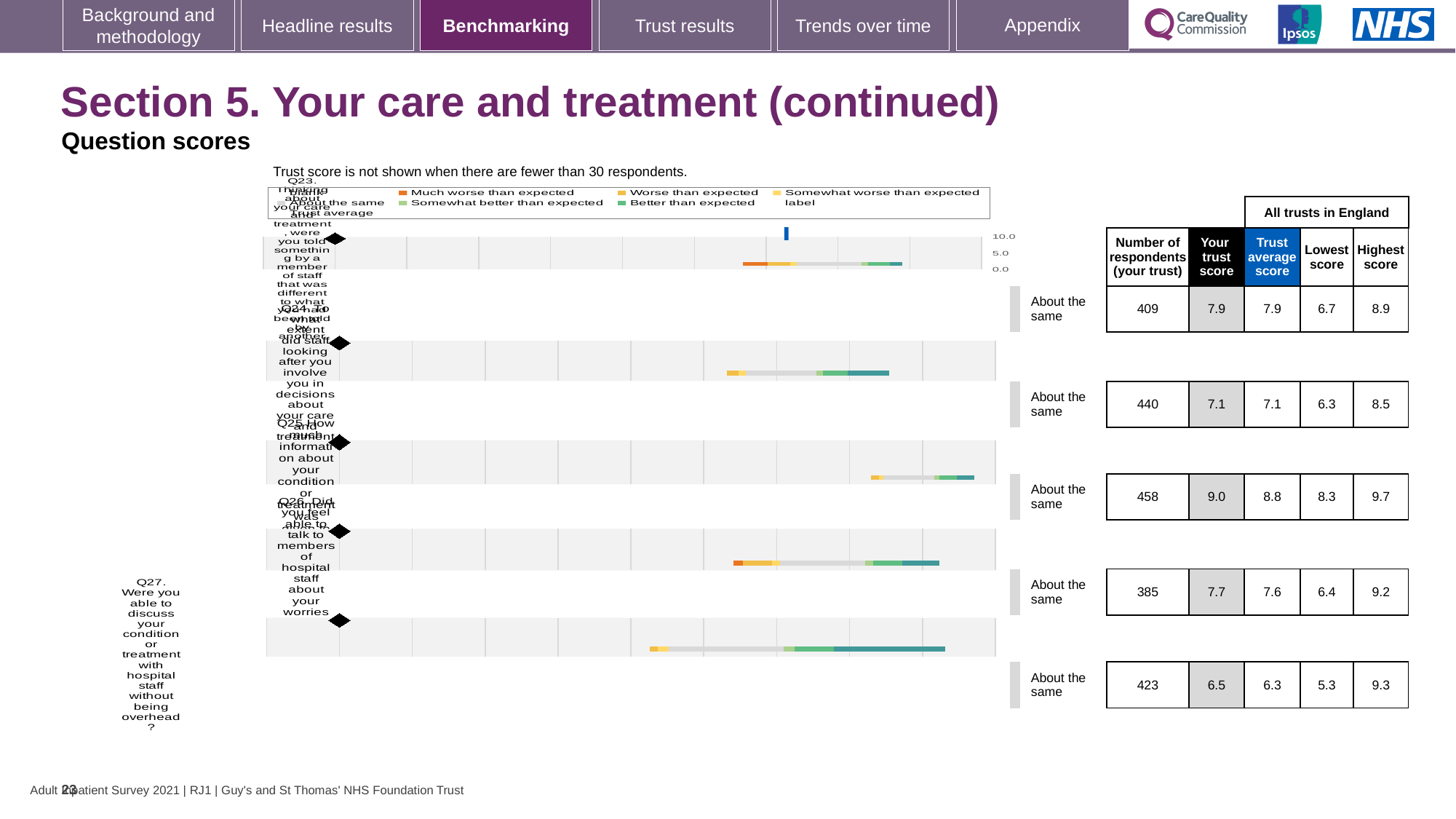
What is the trust score for Q25 (how much information about your condition or treatment was given)? 9.0 What is the highest score across all trusts in England for Q26 (able to talk to hospital staff about your worries)? 9.2 Which question has the highest trust score? Q25 How many questions (Q23 to Q27) are plotted in the chart? 5 What is the trust average score for Q27 (able to discuss your condition or treatment without being overheard)? 6.3 Which has more respondents, Q23 or Q26? Q23 How is the trust's result for Q24 categorised relative to expectations? About the same What kind of chart is used to show the question scores on this slide? bar chart What is the number of respondents for Q24 (did staff involve you in decisions about your care and treatment)? 440 What is the difference between the trust score and the trust average score for Q27? 0.2 What is the lowest score across all trusts in England for Q23? 6.7 Which question has the lowest trust score? Q27